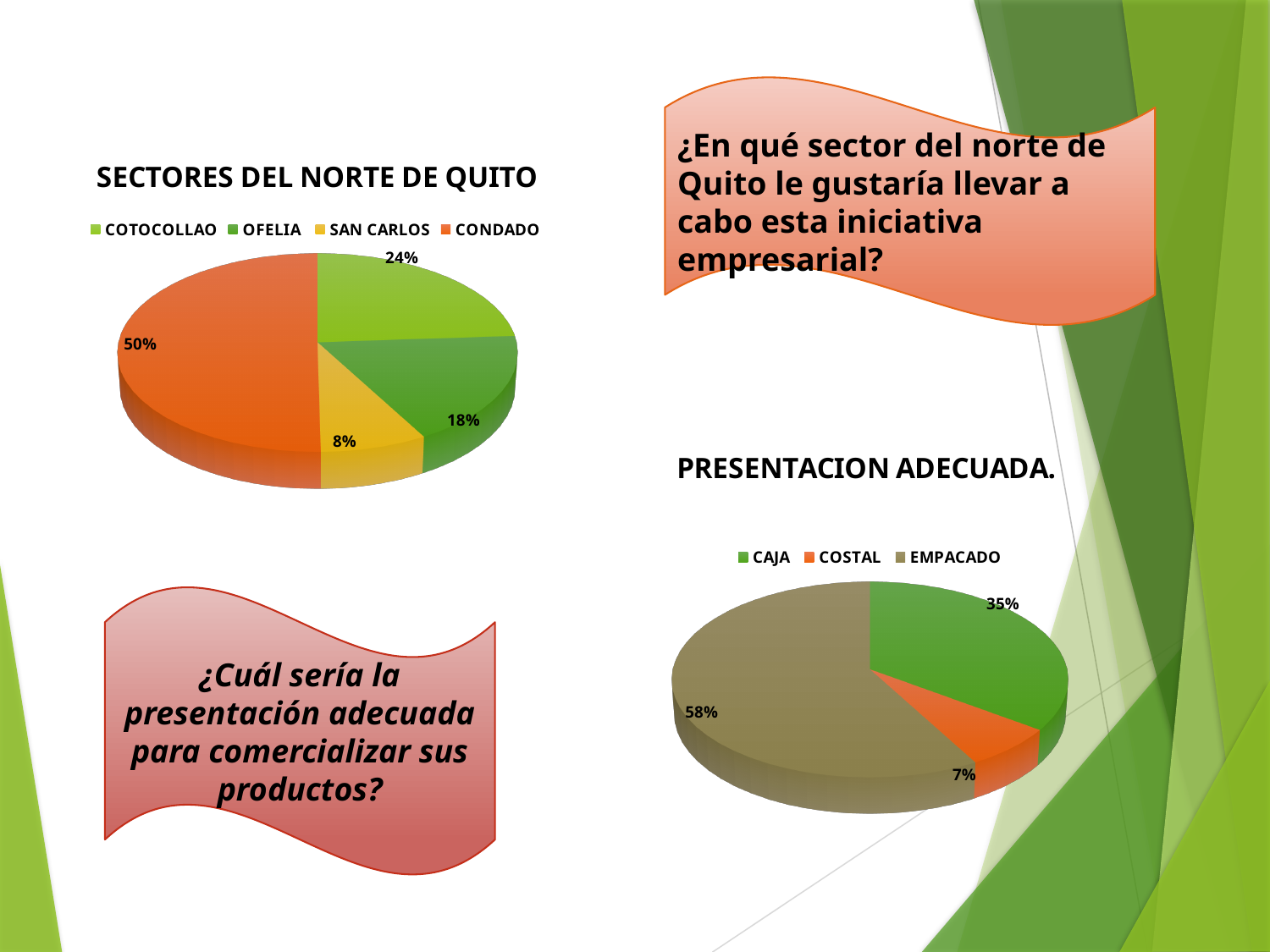
In the 'SECTORES DEL NORTE DE QUITO' chart, what share does COTOCOLLAO have? 24% In the 'PRESENTACION ADECUADA.' chart, what share does EMPACADO have? 58% In the 'SECTORES DEL NORTE DE QUITO' chart, which sector has the smallest share? SAN CARLOS In the 'PRESENTACION ADECUADA.' chart, what share does COSTAL have? 7% How many categories does the 'SECTORES DEL NORTE DE QUITO' chart show? 4 In the 'PRESENTACION ADECUADA.' chart, which is larger, CAJA or COSTAL? CAJA In the 'SECTORES DEL NORTE DE QUITO' chart, what is the difference between the shares of COTOCOLLAO and OFELIA? 6% What kind of chart is 'PRESENTACION ADECUADA.'? Pie chart In the 'PRESENTACION ADECUADA.' chart, what is the difference between the shares of EMPACADO and CAJA? 23% In the 'SECTORES DEL NORTE DE QUITO' chart, which sector has the largest share? CONDADO